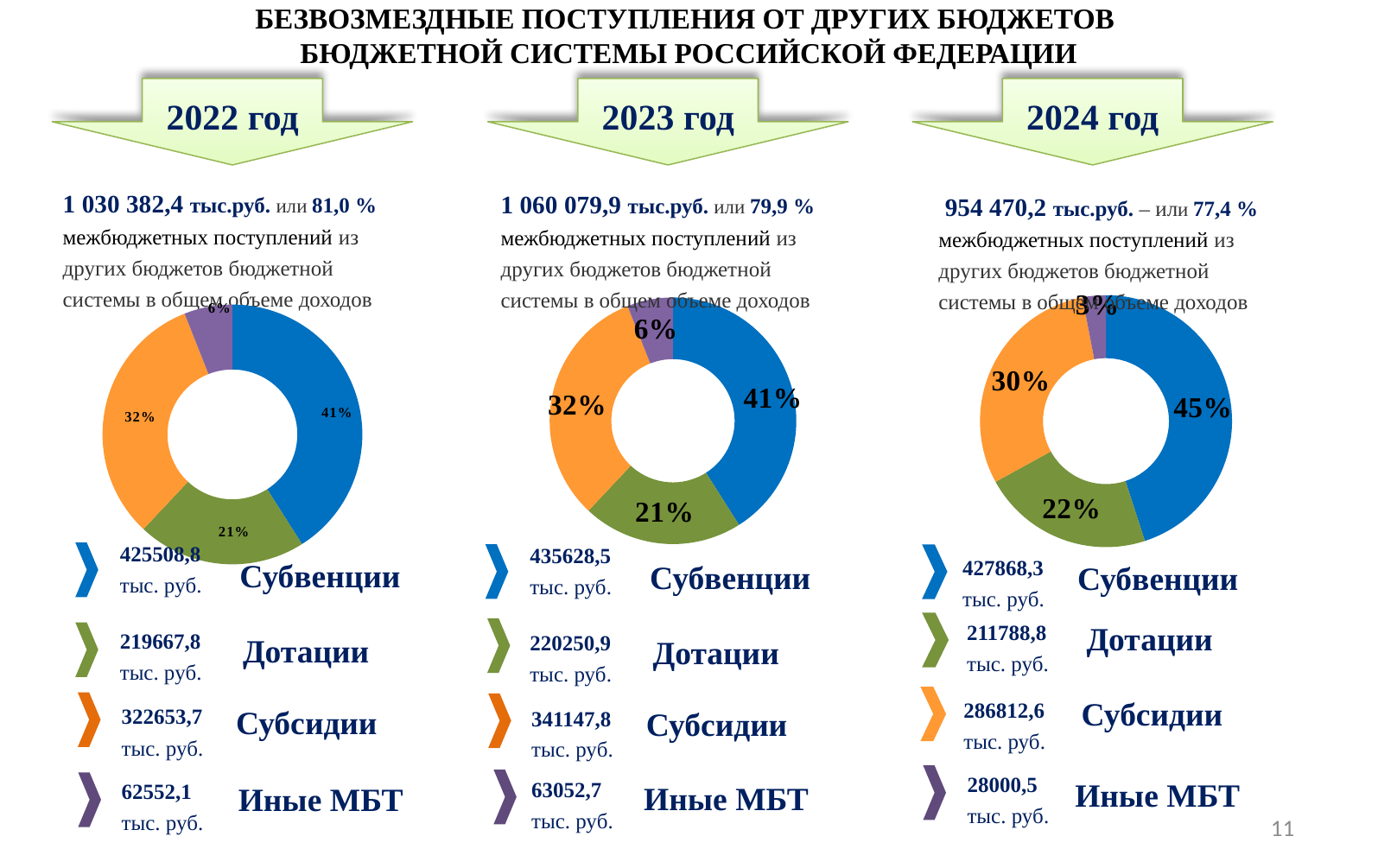
What type of chart is used for each year on the slide? Donut (pie) chart In the 2022 год chart, what share of the donut is Субвенции? 41% In the 2023 год chart, what is the difference in percentage points between the Субвенции slice and the Дотации slice? 20% According to the legend of the 2023 год chart, what is the value for Субсидии? 341147,8 тыс. руб. According to the legend of the 2024 год chart, what is the value for Иные МБТ? 28000,5 тыс. руб. In the 2024 год chart, which slice is larger: Дотации or Субсидии? Субсидии In the 2024 год chart, what share of the donut is Иные МБТ? 3% How many slices does the 2024 год donut chart have? 4 In the 2024 год chart, what share of the donut is Субсидии? 30% In the 2023 год chart, which category has the largest slice? Субвенции Which colour represents Дотации in the donut charts? Green In the 2022 год chart, which category has the smallest slice? Иные МБТ